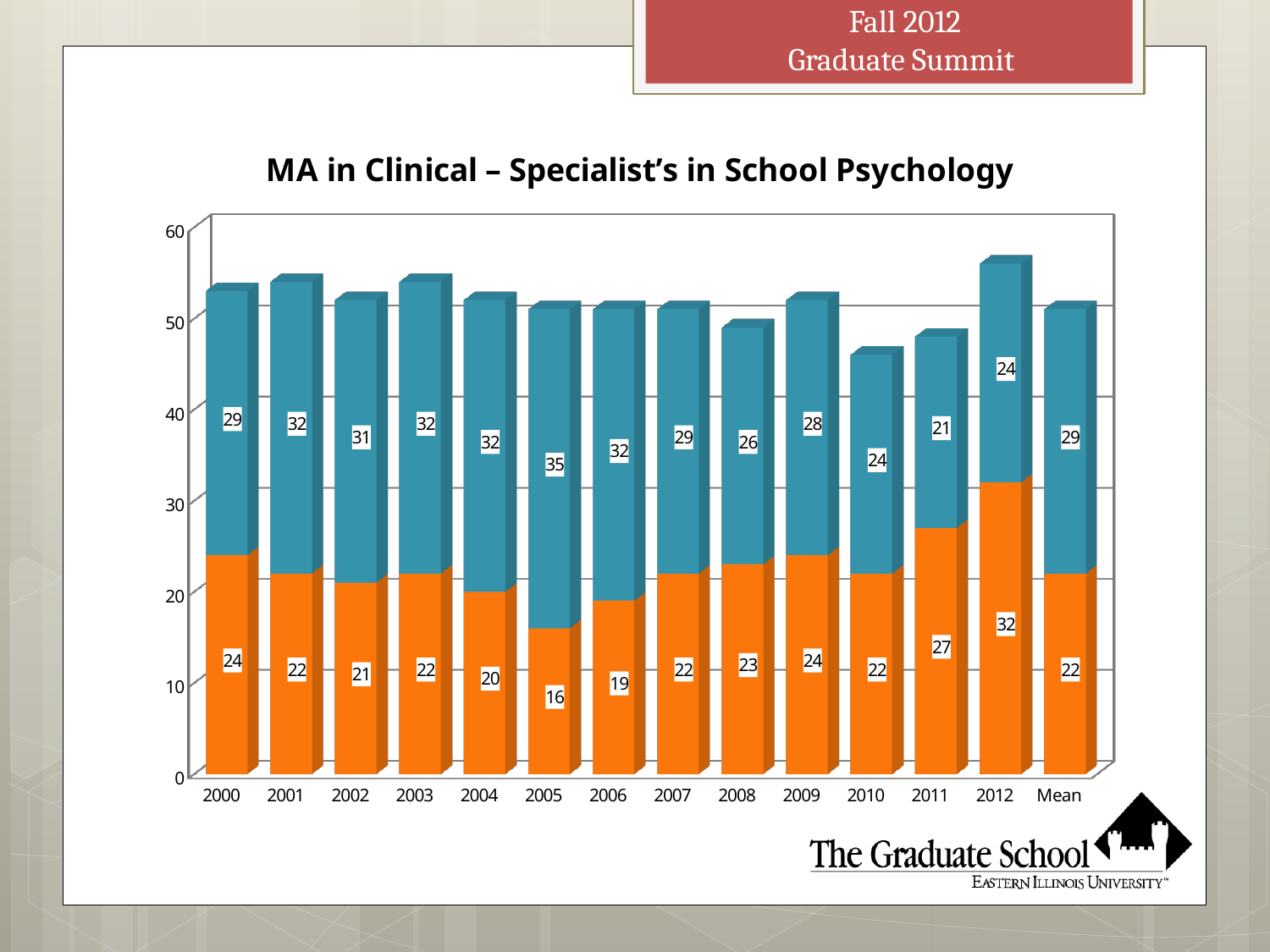
Which category has the highest blue segment value? 2005 What is the title of the chart? MA in Clinical – Specialist's in School Psychology What type of chart is shown on the slide? stacked bar chart How many categories are shown along the x axis of the chart? 14 Is the blue segment value larger for 2008 or for 2009? 2009 Which category has the lowest orange segment value? 2005 What is the value of the orange segment for the Mean bar? 22 What is the value of the orange segment for 2005? 16 What is the difference between the orange segment values for 2012 and 2005? 16 What is the total of the stacked bar for 2012? 56 Which category has the highest orange segment value? 2012 What is the value of the blue segment for 2011? 21